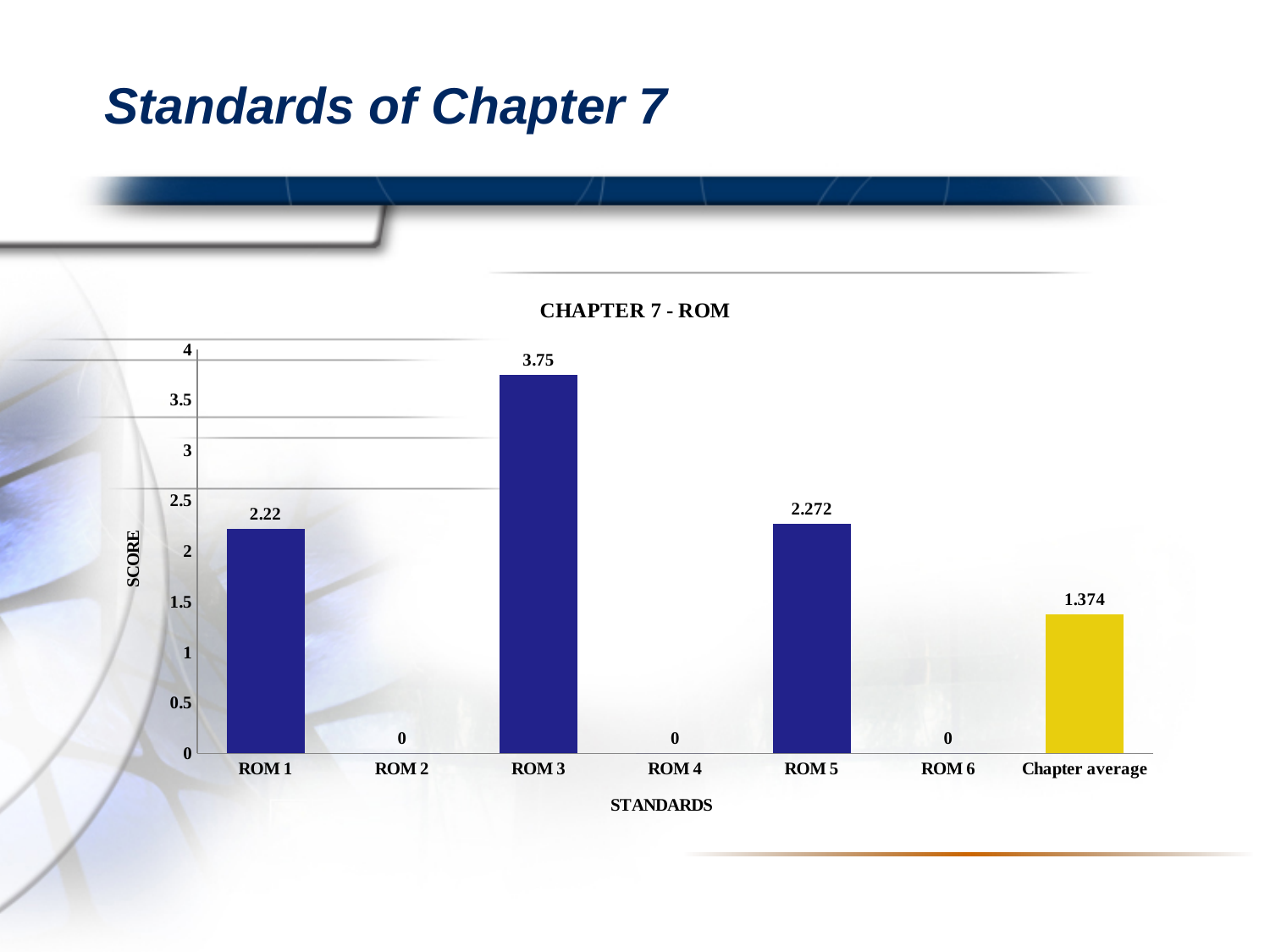
What is the score for ROM 5? 2.272 Which standard has the highest score? ROM 3 What is the value shown for Chapter average? 1.374 What is the score for ROM 1? 2.22 What is the score for ROM 3? 3.75 How many categories are shown on the x axis? 7 Which is larger, the score for ROM 5 or the Chapter average? ROM 5 Is the score for ROM 3 greater or less than 3.5? greater What is the title of the chart? CHAPTER 7 - ROM What is the difference between the scores for ROM 3 and ROM 1? 1.53 What kind of chart is shown on the slide? Bar chart How many standards have a score of 0? 3